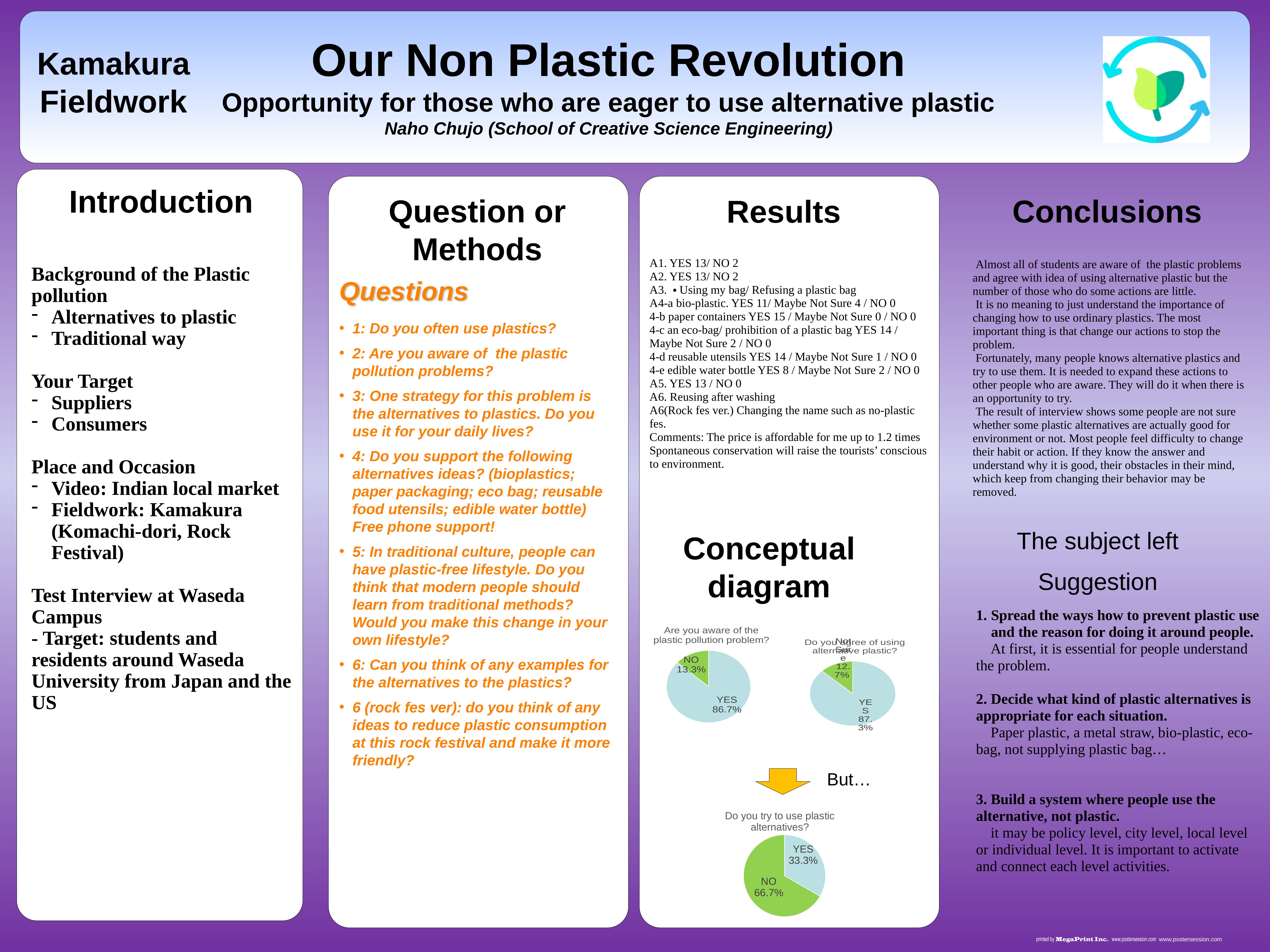
In the pie chart "Do you agree of using alternative plastic?", what share answered YES? 87.3% In the pie chart "Do you try to use plastic alternatives?", what share answered NO? 66.7% In the pie chart "Do you try to use plastic alternatives?", what share answered YES? 33.3% In the pie chart "Do you try to use plastic alternatives?", what is the difference between the NO and YES shares? 33.4% In the pie chart "Do you agree of using alternative plastic?", what share is the smaller slice? 12.7% In the pie chart "Do you try to use plastic alternatives?", which answer has the larger share? NO In the pie chart "Are you aware of the plastic pollution problem?", which answer has the larger share? YES In the pie chart "Are you aware of the plastic pollution problem?", what is the difference between the YES and NO shares? 73.4% In the pie chart "Are you aware of the plastic pollution problem?", what share answered YES? 86.7% What kind of chart is used for "Are you aware of the plastic pollution problem?"? pie chart How many pie charts are shown in the Conceptual diagram section? 3 In the pie chart "Are you aware of the plastic pollution problem?", what share answered NO? 13.3%